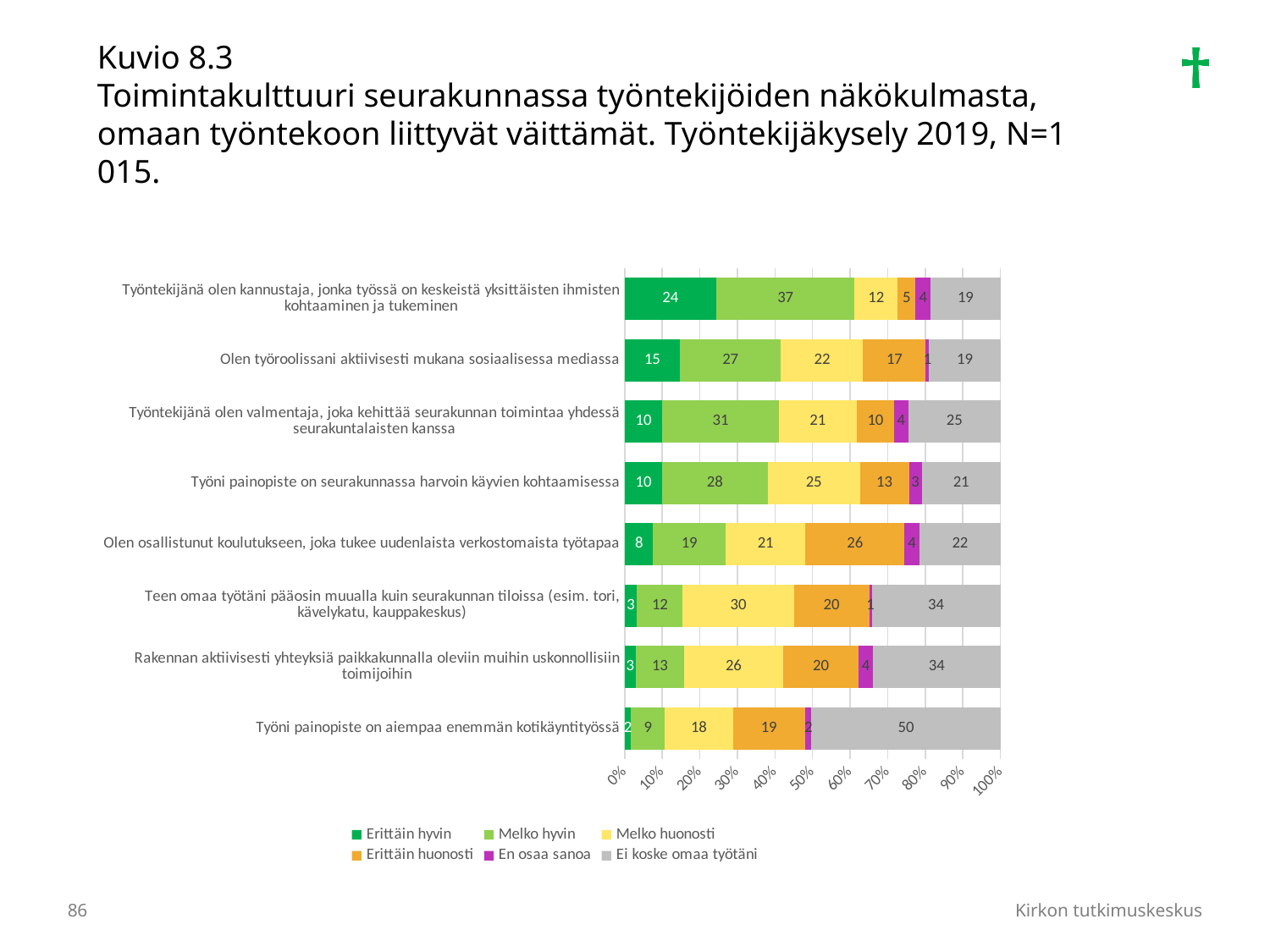
Which is larger: the "Erittäin huonosti" value for "Olen työroolissani aktiivisesti mukana sosiaalisessa mediassa" or for "Työni painopiste on seurakunnassa harvoin käyvien kohtaamisessa"? Olen työroolissani aktiivisesti mukana sosiaalisessa mediassa Which statement has the highest "Erittäin hyvin" value? Työntekijänä olen kannustaja, jonka työssä on keskeistä yksittäisten ihmisten kohtaaminen ja tukeminen How many statements (bars) are shown in the chart? 8 Which statement has the highest "Ei koske omaa työtäni" value? Työni painopiste on aiempaa enemmän kotikäyntityössä What kind of chart is shown on the slide? Stacked bar chart How many series does the legend list? 6 What is the "Melko huonosti" value for "Teen omaa työtäni pääosin muualla kuin seurakunnan tiloissa (esim. tori, kävelykatu, kauppakeskus)"? 30 What percentage of respondents answered "Erittäin hyvin" to "Työntekijänä olen kannustaja, jonka työssä on keskeistä yksittäisten ihmisten kohtaaminen ja tukeminen"? 24 What is the "Ei koske omaa työtäni" value for "Työni painopiste on aiempaa enemmän kotikäyntityössä"? 50 What is the "Erittäin huonosti" value for "Olen osallistunut koulutukseen, joka tukee uudenlaista verkostomaista työtapaa"? 26 What is the difference between the "Melko hyvin" value for "Työntekijänä olen kannustaja..." (37) and for "Olen työroolissani aktiivisesti mukana sosiaalisessa mediassa" (27)? 10 Which statement has the lowest "Erittäin hyvin" value? Työni painopiste on aiempaa enemmän kotikäyntityössä